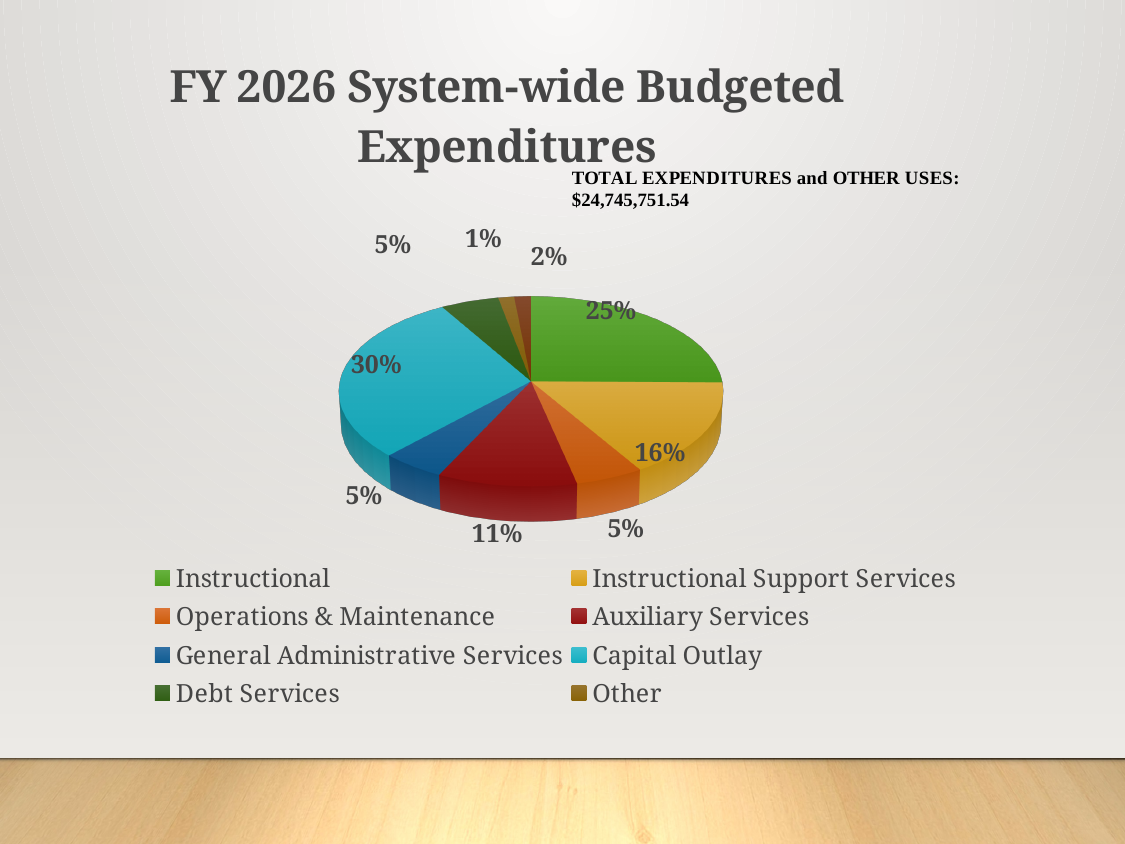
What total expenditures and other uses amount is printed on the slide? $24,745,751.54 How many entries does the legend list? 8 What is the difference between the Capital Outlay share and the Instructional share? 5% What is the value for Instructional Support Services? 16% What share of the pie does Instructional represent? 25% What is the value for Auxiliary Services? 11% What share of the pie does Capital Outlay represent? 30% Which category has the largest slice of the pie? Capital Outlay What is the difference between the Instructional Support Services share and the Auxiliary Services share? 5% Which is larger, Instructional or Instructional Support Services? Instructional What type of chart is shown on the slide? pie chart What is the value for Operations & Maintenance? 5%